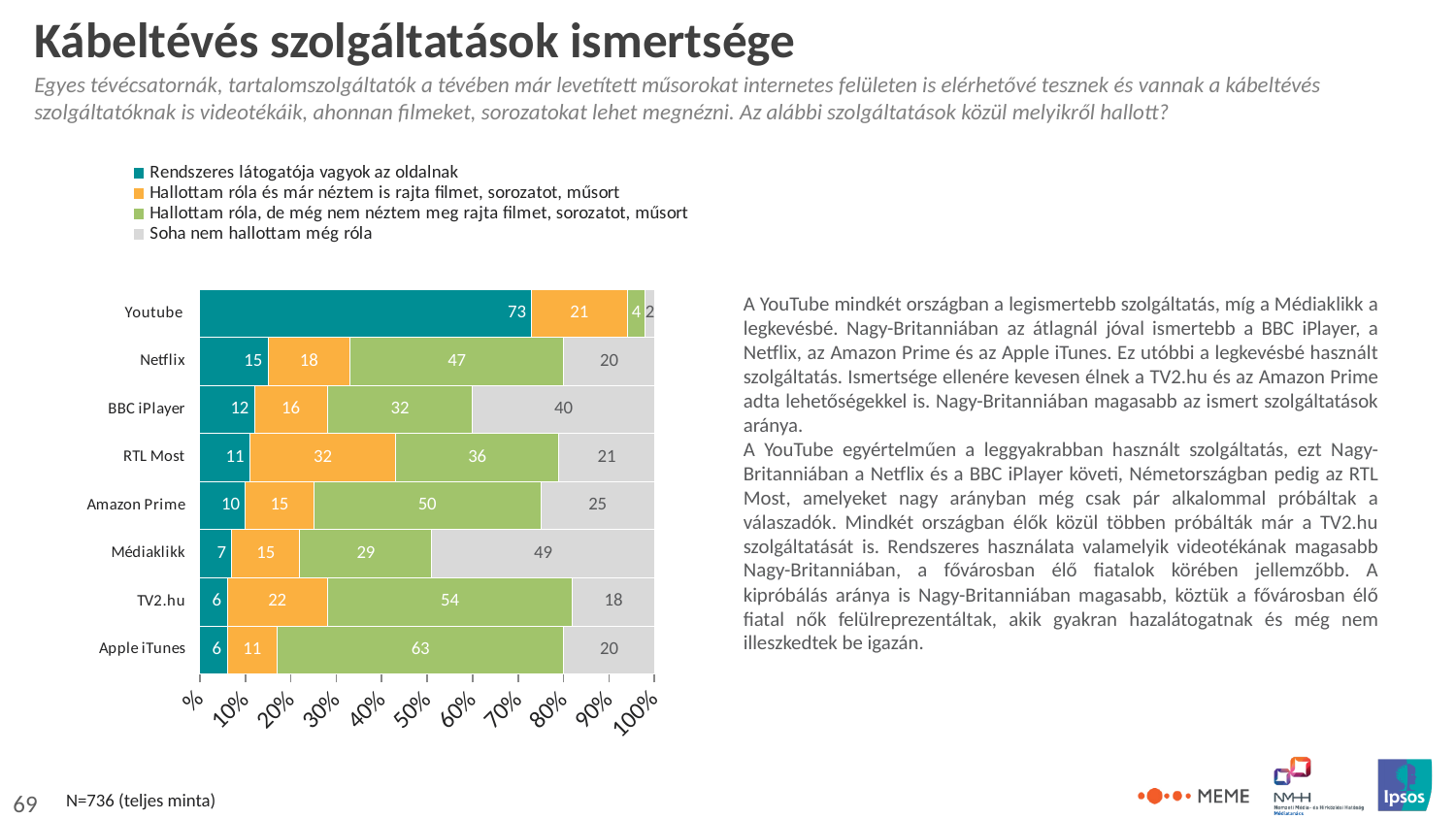
How many categories (services) are shown on the chart? 8 Which category has the lowest value in the "Rendszeres látogatója vagyok az oldalnak" series? TV2.hu and Apple iTunes What kind of chart is shown on the slide? Stacked bar chart What is the difference between the "Hallottam róla és már néztem is rajta filmet, sorozatot, műsort" values for RTL Most and Netflix? 14 Which category has the highest value in the "Soha nem hallottam még róla" series? Médiaklikk What is the value for BBC iPlayer in the "Soha nem hallottam még róla" series? 40 What is the total of the stacked bar for Netflix? 100 What is the value for Youtube in the "Rendszeres látogatója vagyok az oldalnak" series? 73 What is the value for Apple iTunes in the "Hallottam róla, de még nem néztem meg rajta filmet, sorozatot, műsort" series? 63 How many series does the legend list? 4 Which is larger: the "Soha nem hallottam még róla" value for Amazon Prime or for RTL Most? Amazon Prime What is the title of the slide? Kábeltévés szolgáltatások ismertsége